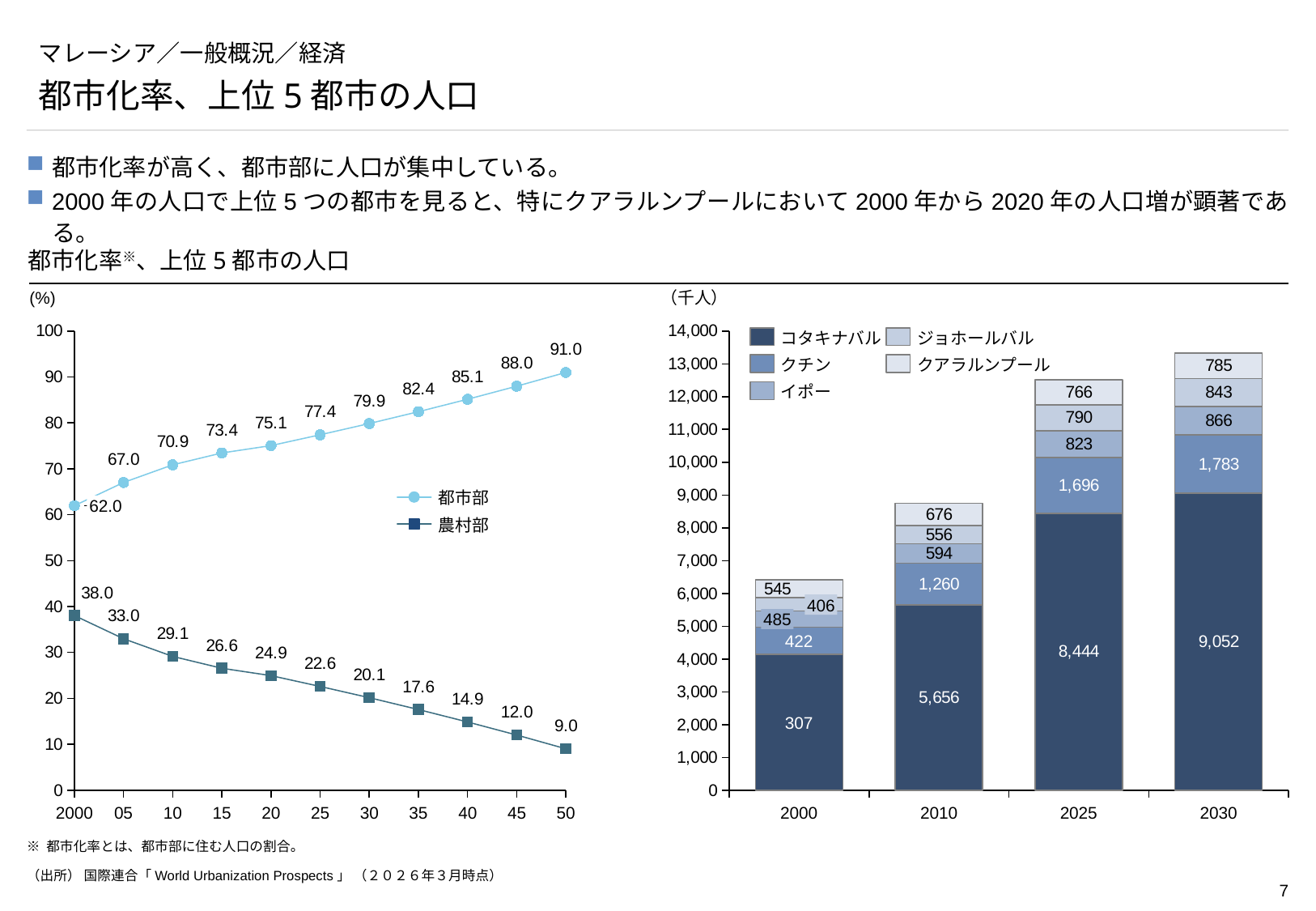
In the right stacked bar chart, which year has the larger value for コタキナバル, 2025 or 2030? 2030 How many series does the legend of the right chart list? 5 How many series does the legend of the left chart list? 2 How many years are shown on the x axis of the right chart? 4 In the left line chart, do the 都市部 values rise or fall from 2000 to 2050? rise In the right stacked bar chart, what is the value for コタキナバル in 2030? 9,052 In the left line chart, what is the difference between the 都市部 value in 2050 and in 2000? 29.0 In the left line chart, what is the value for 都市部 in 2030? 79.9 In the right stacked bar chart, what is the value for クチン in 2010? 1,260 In the left line chart, what is the value for 農村部 in 2000? 38.0 What kind of chart is the chart on the left? line chart In the right stacked bar chart, is the total height of the 2030 bar greater or less than 13,000? greater